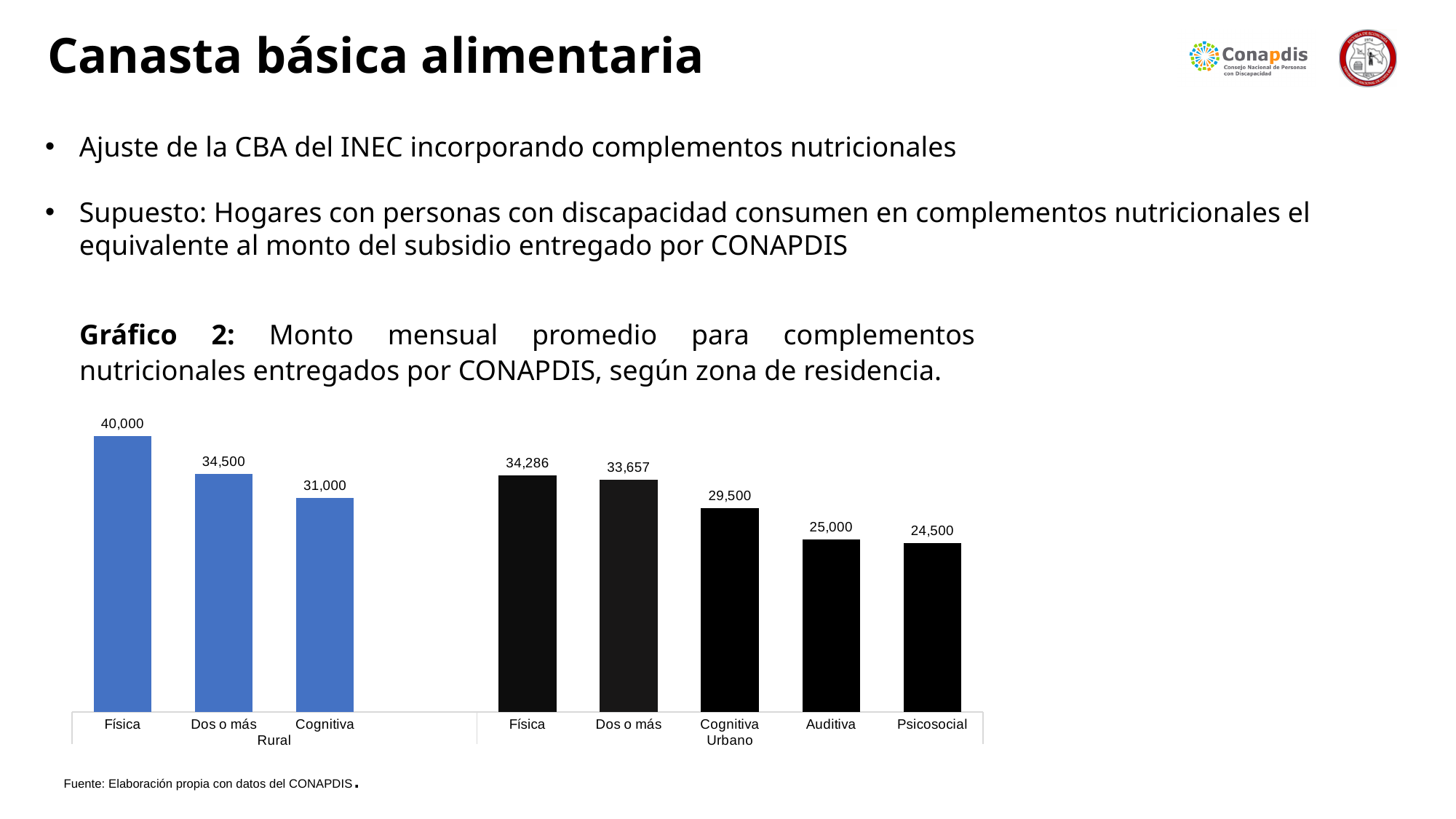
What colour are the bars for the Rural zone? Blue What is the difference between Dos o más in the Rural zone and Cognitiva in the Rural zone? 3,500 What is the value for Física in the Rural zone? 40,000 Which category has the lowest value in the chart? Psicosocial (Urbano) Which is larger: Dos o más in the Rural zone or Dos o más in the Urbano zone? Dos o más in the Rural zone Which category has the highest value in the chart? Física (Rural) What is the difference between Física in the Rural zone and Física in the Urbano zone? 5,714 What is the value for Cognitiva in the Urbano zone? 29,500 What kind of chart is shown on the slide? Bar chart How many bars are plotted in the chart in total? 8 What is the value for Psicosocial in the Urbano zone? 24,500 How many categories are shown for the Urbano zone? 5